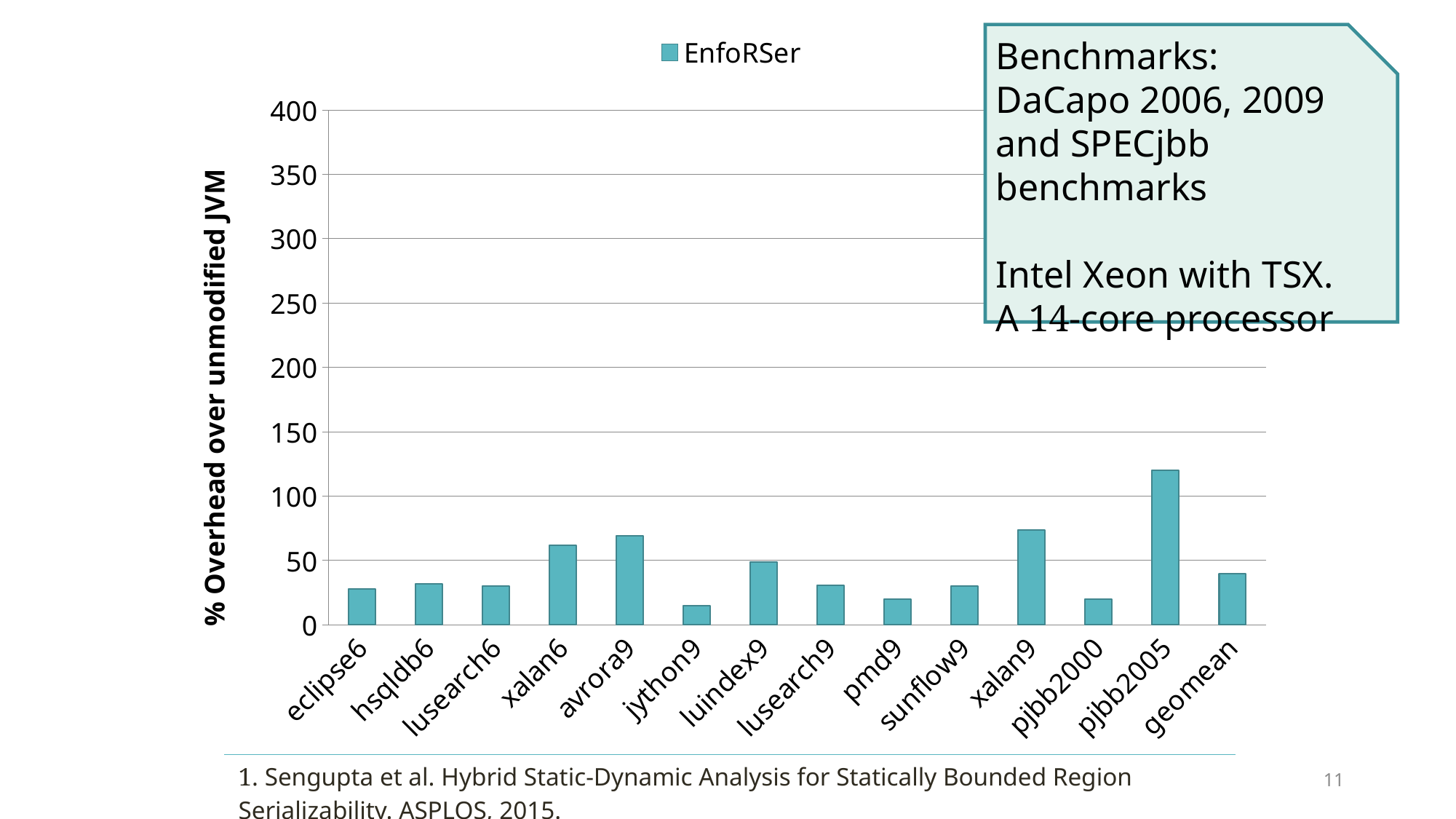
Is the value for pjbb2005 greater or less than 100? greater Is the value for jython9 greater or less than 50? less How many series does the legend list? 1 Which has the larger overhead, pjbb2005 or xalan9? pjbb2005 What is the label of the vertical axis? % Overhead over unmodified JVM How many benchmark categories are plotted along the x axis? 14 Is the value for geomean greater or less than 50? less Which has the larger overhead, xalan9 or xalan6? xalan9 What is the name of the series shown in the legend? EnfoRSer Which benchmark has the highest overhead? pjbb2005 What kind of chart is shown on the slide? bar chart